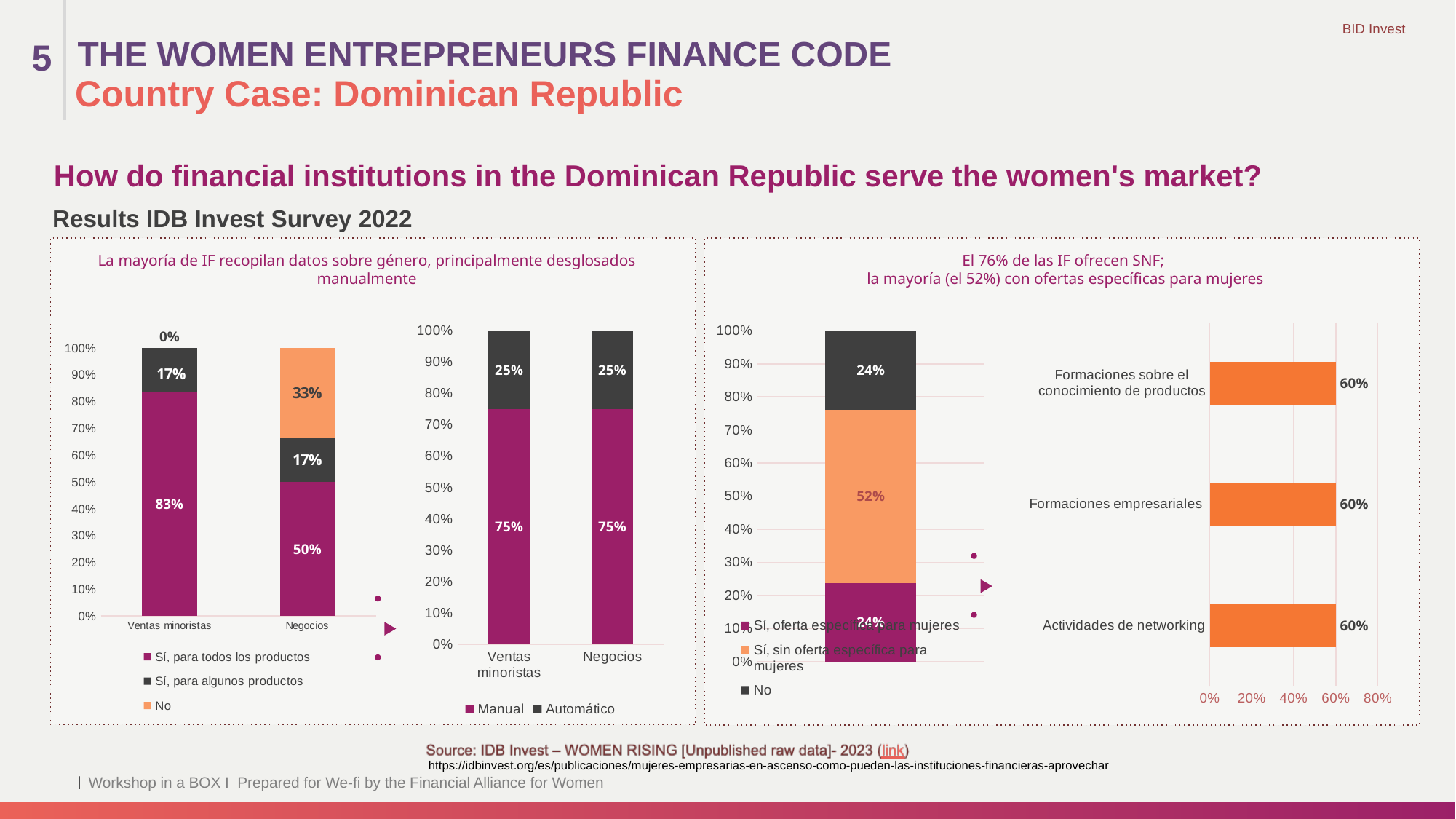
In the second chart from the left (Manual / Automático), which series is larger for Ventas minoristas, Manual or Automático? Manual What type of chart is the rightmost chart on the slide? Bar chart In the leftmost stacked bar chart, how many series does the legend list? 3 In the leftmost stacked bar chart, what is the difference between the 'Sí, para todos los productos' values for Ventas minoristas and Negocios? 33% In the leftmost stacked bar chart, what is the value of 'Sí, para todos los productos' for Ventas minoristas? 83% In the third chart from the left (single stacked bar about SNF), what is the value of 'No'? 24% In the leftmost stacked bar chart, what is the value of 'No' for Negocios? 33% In the second chart from the left (Manual / Automático), what is the Automático value for Ventas minoristas? 25% In the third chart from the left (single stacked bar about SNF), what is the value of 'Sí, sin oferta específica para mujeres'? 52% In the rightmost chart, what is the value for Actividades de networking? 60% In the second chart from the left (Manual / Automático), what is the Manual value for Negocios? 75% In the third chart from the left (single stacked bar about SNF), which segment is the largest? Sí, sin oferta específica para mujeres